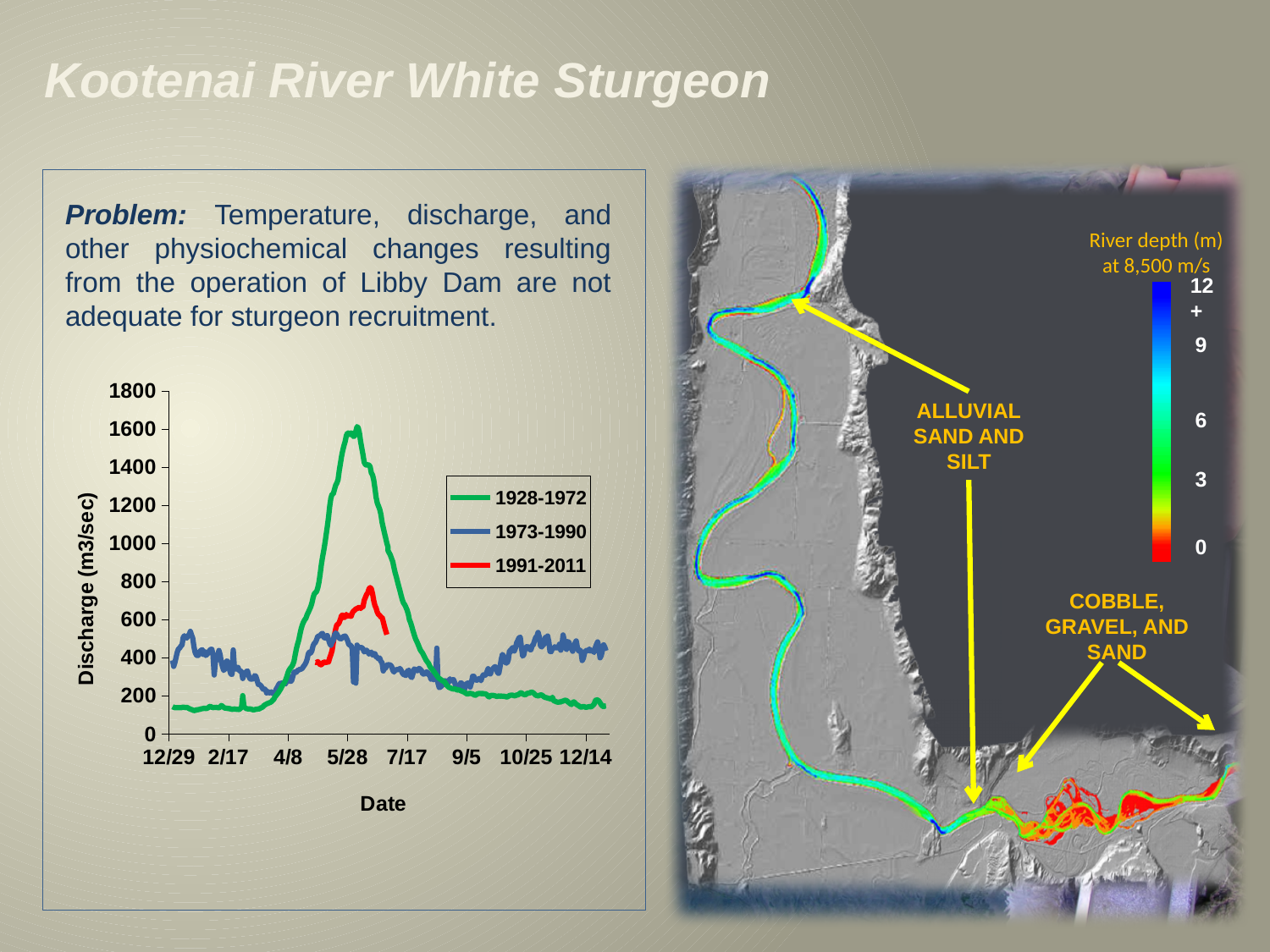
What kind of chart is shown on the slide? line chart Is the value of the 1928-1972 series at 12/29 greater or less than 400? less Around 5/28, which series has the higher discharge, 1928-1972 or 1973-1990? 1928-1972 Is the peak value of the 1973-1990 series greater or less than 800? less Which series reaches the highest peak discharge on the chart? 1928-1972 How many series does the chart's legend list? 3 What is the label on the chart's vertical axis? Discharge (m3/sec) What are the three series named in the chart's legend? 1928-1972, 1973-1990, 1991-2011 Is the peak value of the 1928-1972 series greater or less than 1400? greater Does the 1928-1972 series rise or fall between 4/8 and 5/28? rise How many date labels are shown on the chart's horizontal axis? 8